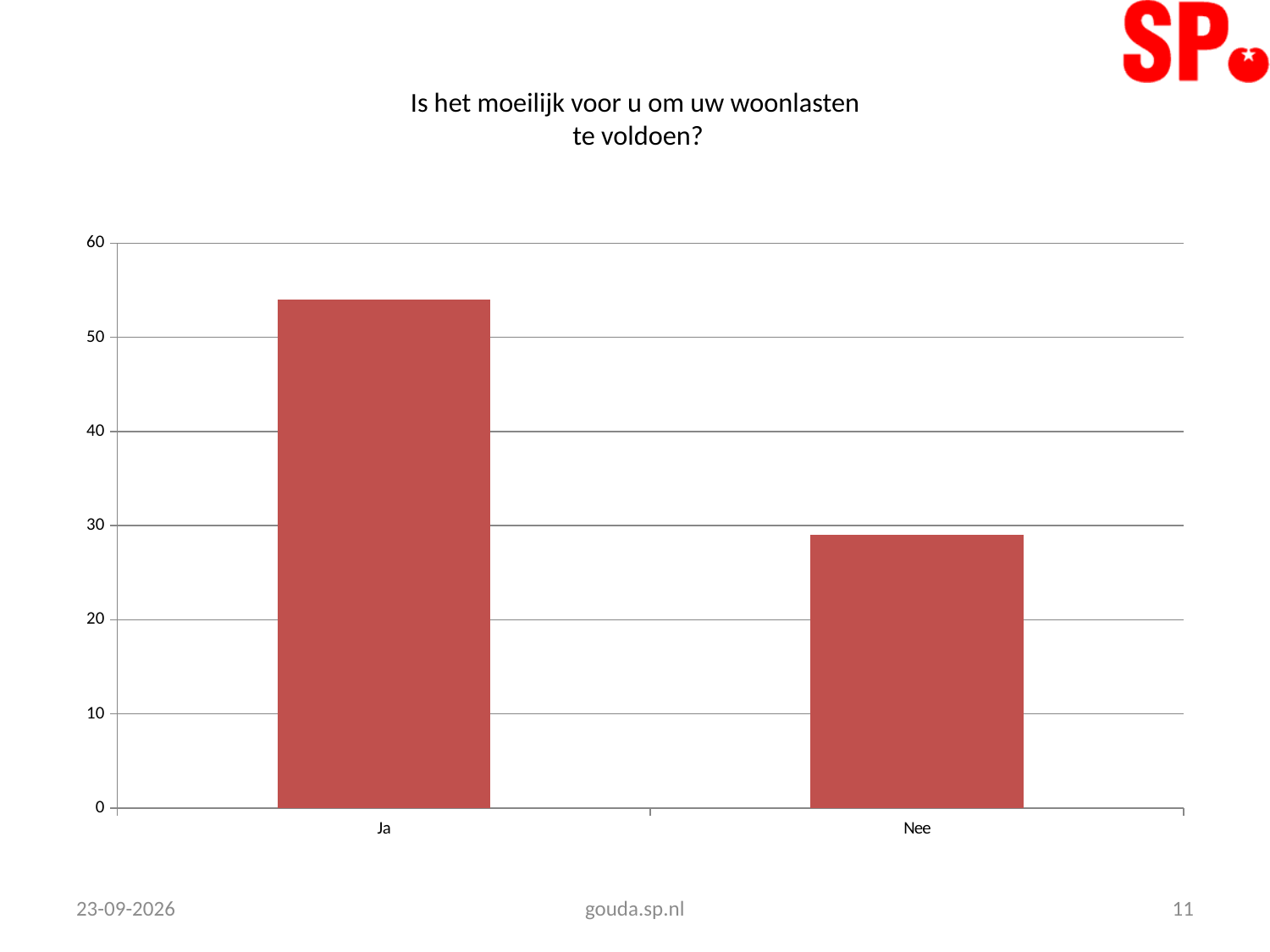
What is the highest value shown on the vertical axis? 60 Which category has the highest bar? Ja Which category has the lowest bar? Nee How many categories are shown on the x axis of the chart? 2 Which is larger, the value for Ja or the value for Nee? Ja Is the value for Ja greater or less than 50? greater Is the value for Ja greater or less than 60? less What is the title of the chart? Is het moeilijk voor u om uw woonlasten te voldoen? Is the value for Nee greater or less than 20? greater What kind of chart is shown on the slide? bar chart